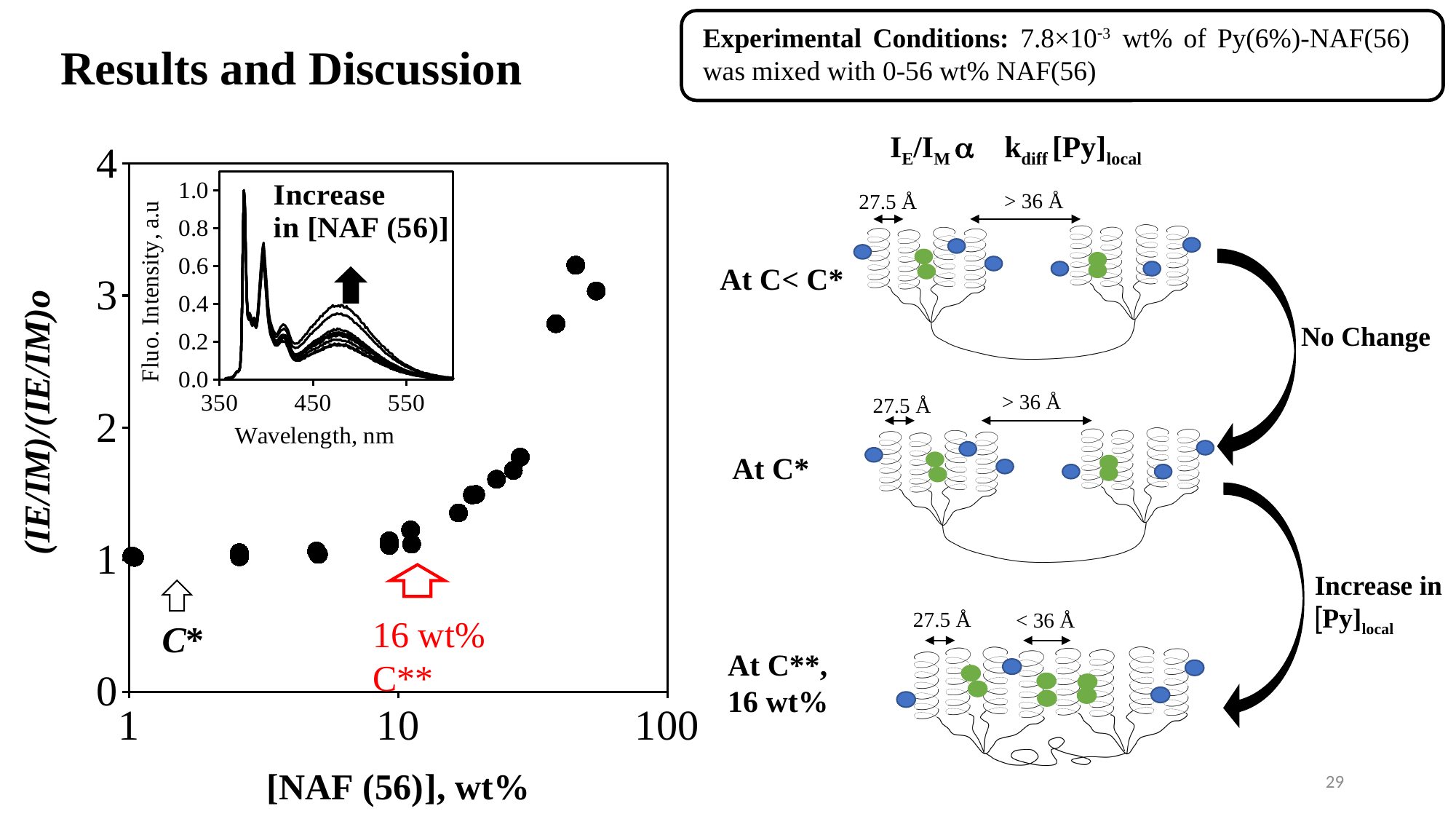
In the main chart, is the value at about 40 wt% NAF (56) greater or less than 3? less In the main chart, what is the label of the x axis? [NAF (56)], wt% In the main chart, what NAF (56) concentration is marked by the red arrow as C**? 16 wt% In the main chart, which is larger: the value at about 50 wt% NAF (56) or the value at about 10 wt% NAF (56)? the value at about 50 wt% In the inset chart, what is the label of the x axis? Wavelength, nm What kind of chart is the main plot on the left of the slide? scatter plot In the main chart, is the value at about 5 wt% NAF (56) greater or less than 2? less In the main chart, what is the label of the y axis? (IE/IM)/(IE/IM)o In the main chart, is the value at 1 wt% NAF (56) greater or less than 2? less In the main chart, do the plotted values generally rise or fall as [NAF (56)] increases along the x axis? rise